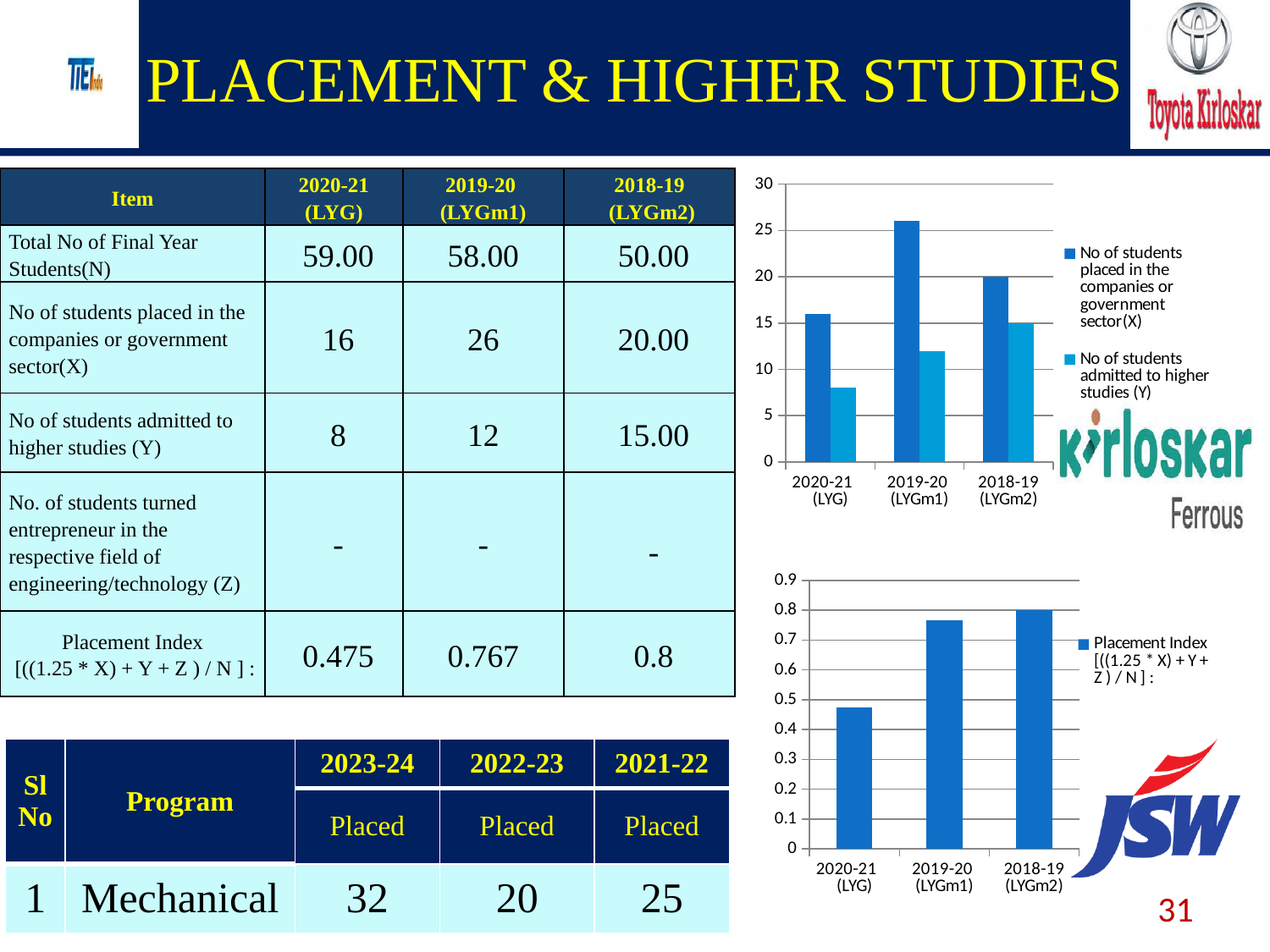
In the top chart, is the value for students admitted to higher studies (Y) in 2020-21 (LYG) greater or less than 10? less What kind of chart is the bottom chart (Placement Index) on the slide? bar chart In the top chart, which year has the lowest number of students admitted to higher studies (Y)? 2020-21 (LYG) In the top chart, what is the number of students admitted to higher studies (Y) for 2018-19 (LYGm2)? 15 What kind of chart is the top chart on the right of the slide? bar chart How many series does the legend of the top chart list? 2 In the top chart, is the value for students placed (X) in 2019-20 (LYGm1) greater or less than 25? greater In the bottom Placement Index chart, which year has the lowest placement index? 2020-21 (LYG) In the top chart, which year has the highest number of students placed in the companies or government sector (X)? 2019-20 (LYGm1) In the bottom Placement Index chart, is the value for 2020-21 (LYG) greater or less than 0.5? less In the top chart, for 2018-19 (LYGm2), which is larger: students placed (X) or students admitted to higher studies (Y)? students placed (X) How many year categories are shown on the x axis of the top chart? 3